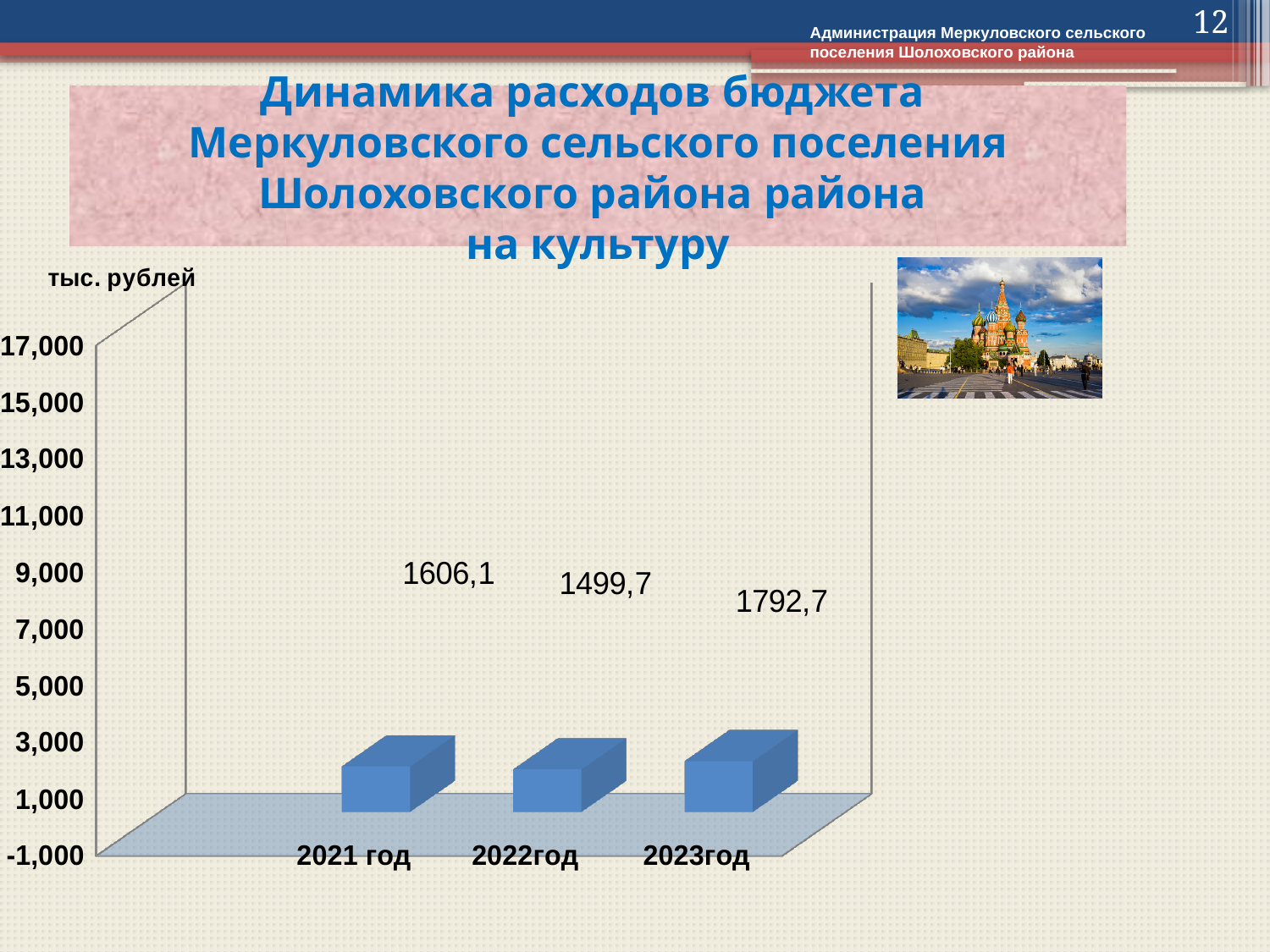
How many years are shown on the chart? 3 What kind of chart is shown on the slide? bar chart What is the value for 2023год? 1792,7 What is the value for 2021 год? 1606,1 Is the value for 2023год greater or less than 3,000? less Which year has the lowest value? 2022год Which year has the highest value? 2023год What is the difference between the values for 2021 год and 2022год? 106,4 Which is larger, the value for 2021 год or the value for 2022год? 2021 год What is the value for 2022год? 1499,7 What unit is indicated for the values on the chart? тыс. рублей What is the difference between the values for 2023год and 2021 год? 186,6